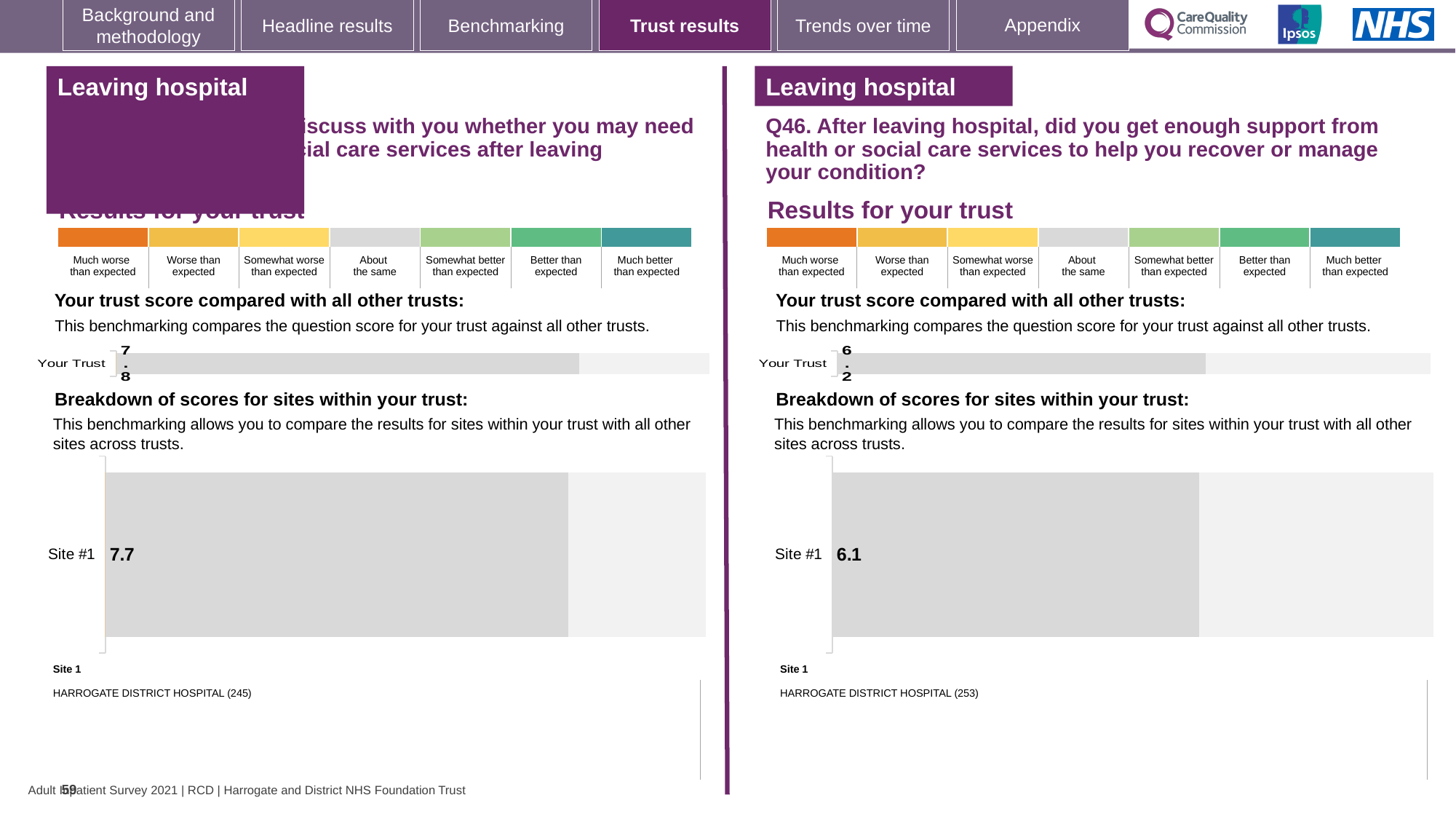
On the left-hand chart, what is the score shown for Your Trust? 7.8 Which is higher: the Your Trust score on the left-hand chart or the Your Trust score on the right-hand chart for Q46? The left-hand chart (7.8) On the right-hand chart for Q46, what is the score shown for Your Trust? 6.2 Which is higher: the Site #1 score on the left-hand chart or the Site #1 score on the right-hand chart for Q46? The left-hand chart (7.7) On the right-hand chart for Q46, what is the difference between the Your Trust score and the Site #1 score? 0.1 On the left-hand side, what number is shown in brackets after HARROGATE DISTRICT HOSPITAL for Site 1? 245 What kind of chart is used to show the Site #1 score on the right-hand side for Q46? Bar chart On the right-hand chart for Q46, what is the score shown for Site #1 in the breakdown of scores for sites? 6.1 On the left-hand chart, what is the difference between the Your Trust score and the Site #1 score? 0.1 On the right-hand side for Q46, which hospital is listed as Site 1? HARROGATE DISTRICT HOSPITAL (253) On the right-hand chart for Q46, how many sites are shown in the breakdown of scores for sites within your trust? 1 On the left-hand chart, what is the score shown for Site #1 in the breakdown of scores for sites? 7.7